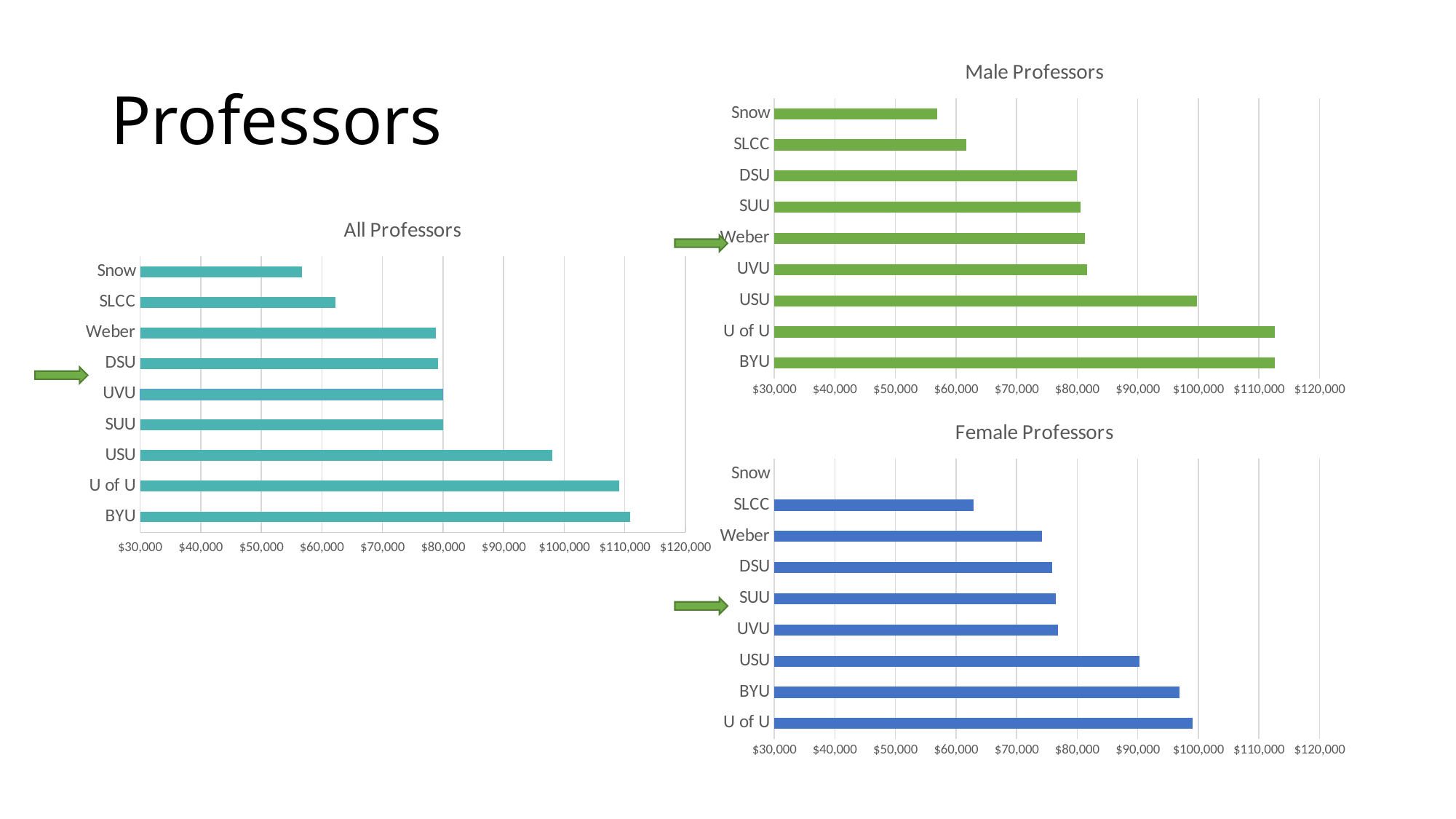
On the All Professors chart, which institution has the lowest value? Snow What is the title of the chart on the bottom right of the slide? Female Professors On the All Professors chart, is the value for Snow greater or less than $60,000? less On the Male Professors chart, which institution has the lowest value? Snow What kind of chart is the All Professors chart? bar chart On the All Professors chart, is the value for USU greater or less than $90,000? greater On the Female Professors chart, which is larger, the value for BYU or the value for USU? BYU On the All Professors chart, which institution has the highest value? BYU How many institutions are listed on the Male Professors chart? 9 On the Male Professors chart, is the value for U of U greater or less than $110,000? greater On the Female Professors chart, which institution has the highest value? U of U